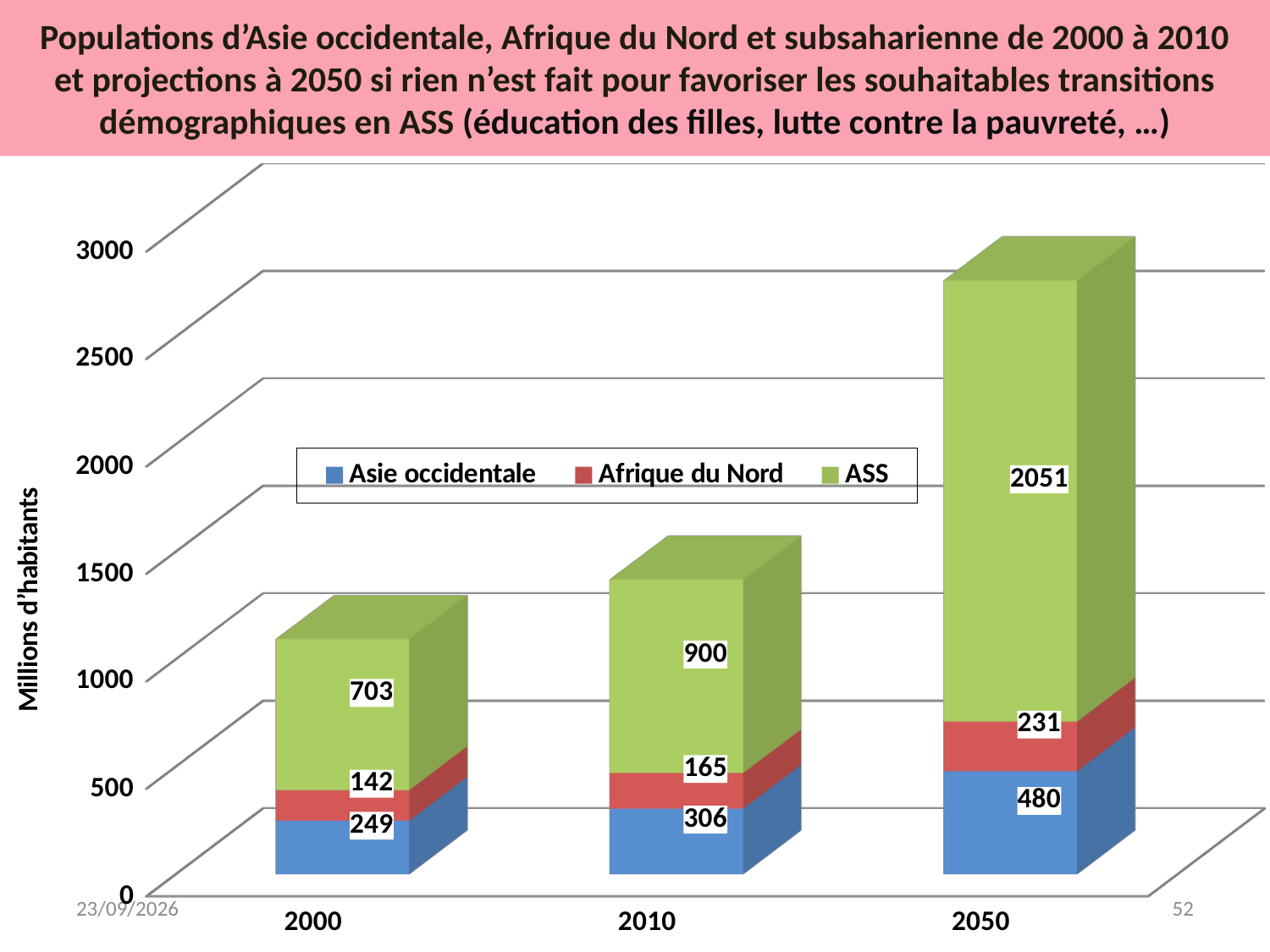
What is the value for Asie occidentale in 2000? 249 Which is larger: Asie occidentale in 2050 or ASS in 2000? ASS in 2000 What is the difference between the ASS values for 2010 and 2000? 197 How many series does the legend list? 3 How many years are shown on the x axis? 3 What is the total of the stacked bar for 2000? 1094 In which year is the ASS value highest? 2050 What is the value for ASS in 2050? 2051 What is the total of the stacked bar for 2010? 1371 What kind of chart is shown? Stacked bar chart In which year is the Afrique du Nord value lowest? 2000 What is the value for Afrique du Nord in 2010? 165